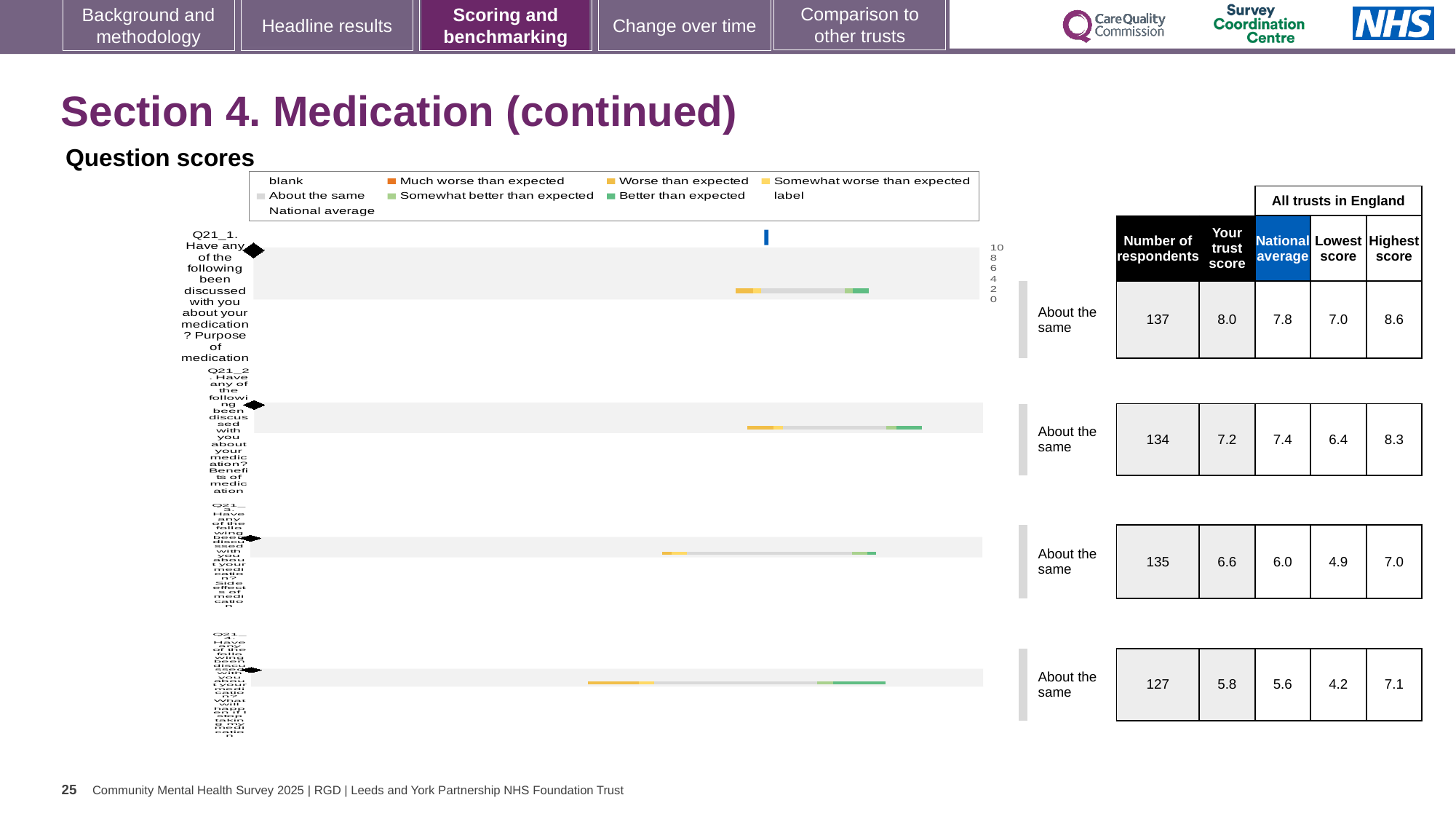
What is the highest score across all trusts in England for the third question row? 7.0 What is the difference between the trust score and the national average for Q21_1 (Purpose of medication)? 0.2 What is the national average for the second question row (Q21_2, Benefits of medication)? 7.4 What kind of chart is shown under 'Question scores'? bar chart Which legend entry is shown in grey? About the same What is the lowest score across all trusts in England for the fourth question row? 4.2 What is the trust score for Q21_1 (Purpose of medication)? 8.0 For the second question row (Q21_2), is the trust score or the national average higher? national average How many entries does the chart legend list? 9 How many question bars are plotted in the chart? 4 Which question row has the lowest number of respondents? the fourth row (Q21_4), 127 What is the number of respondents for Q21_1 (Purpose of medication)? 137